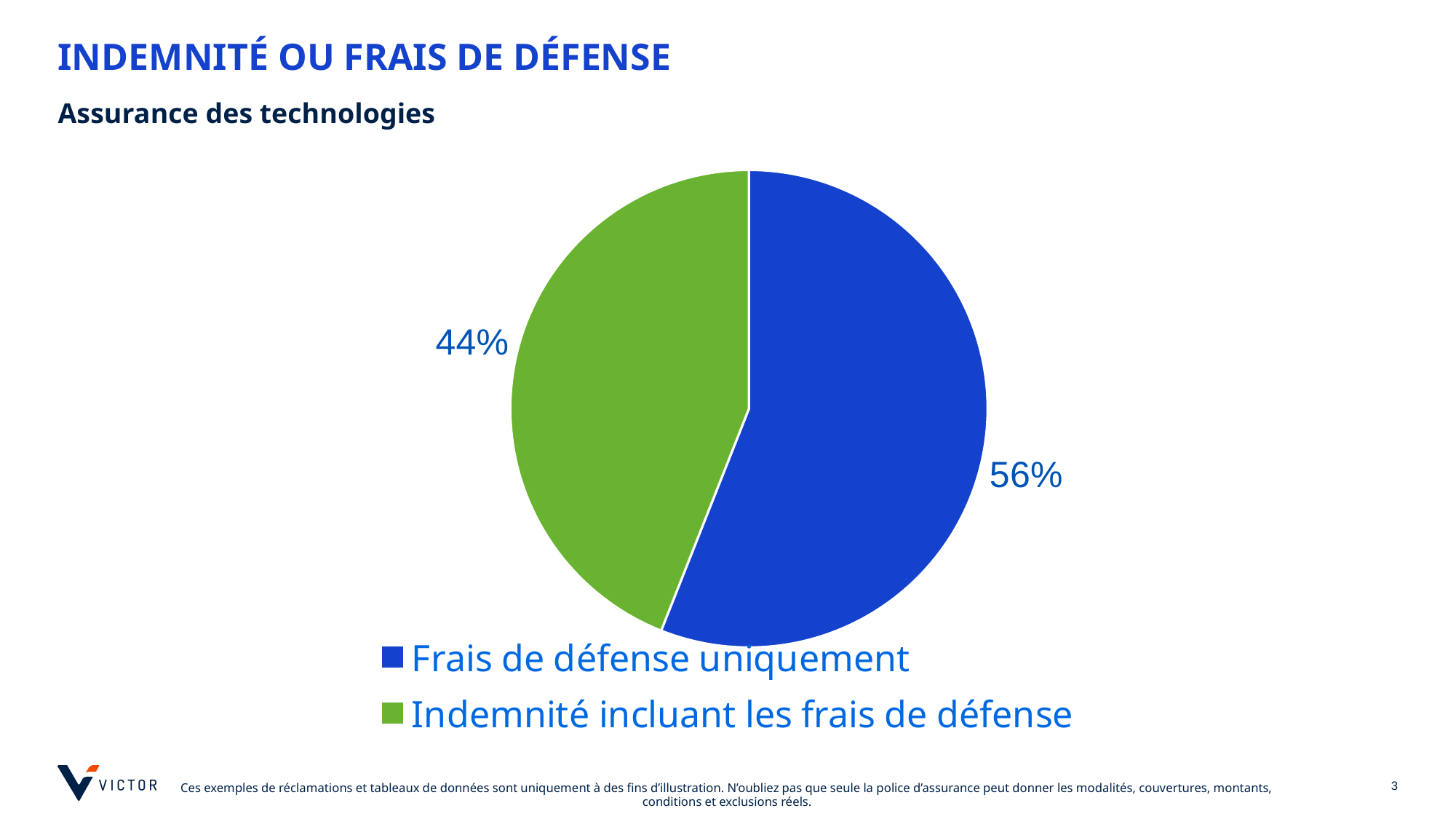
How many entries does the legend list? 2 What share of the pie is 'Frais de défense uniquement'? 56% What kind of chart is shown on the slide? Pie chart What share of the pie is 'Indemnité incluant les frais de défense'? 44% Is the share for 'Frais de défense uniquement' greater or less than 50%? greater What is the difference in percentage points between 'Frais de défense uniquement' and 'Indemnité incluant les frais de défense'? 12 Which category has the smallest slice of the pie? Indemnité incluant les frais de défense Which category has the largest slice of the pie? Frais de défense uniquement How many slices does the pie chart have? 2 What colour is the slice for 'Indemnité incluant les frais de défense'? Green Which is larger: 'Frais de défense uniquement' or 'Indemnité incluant les frais de défense'? Frais de défense uniquement What colour is the slice for 'Frais de défense uniquement'? Blue